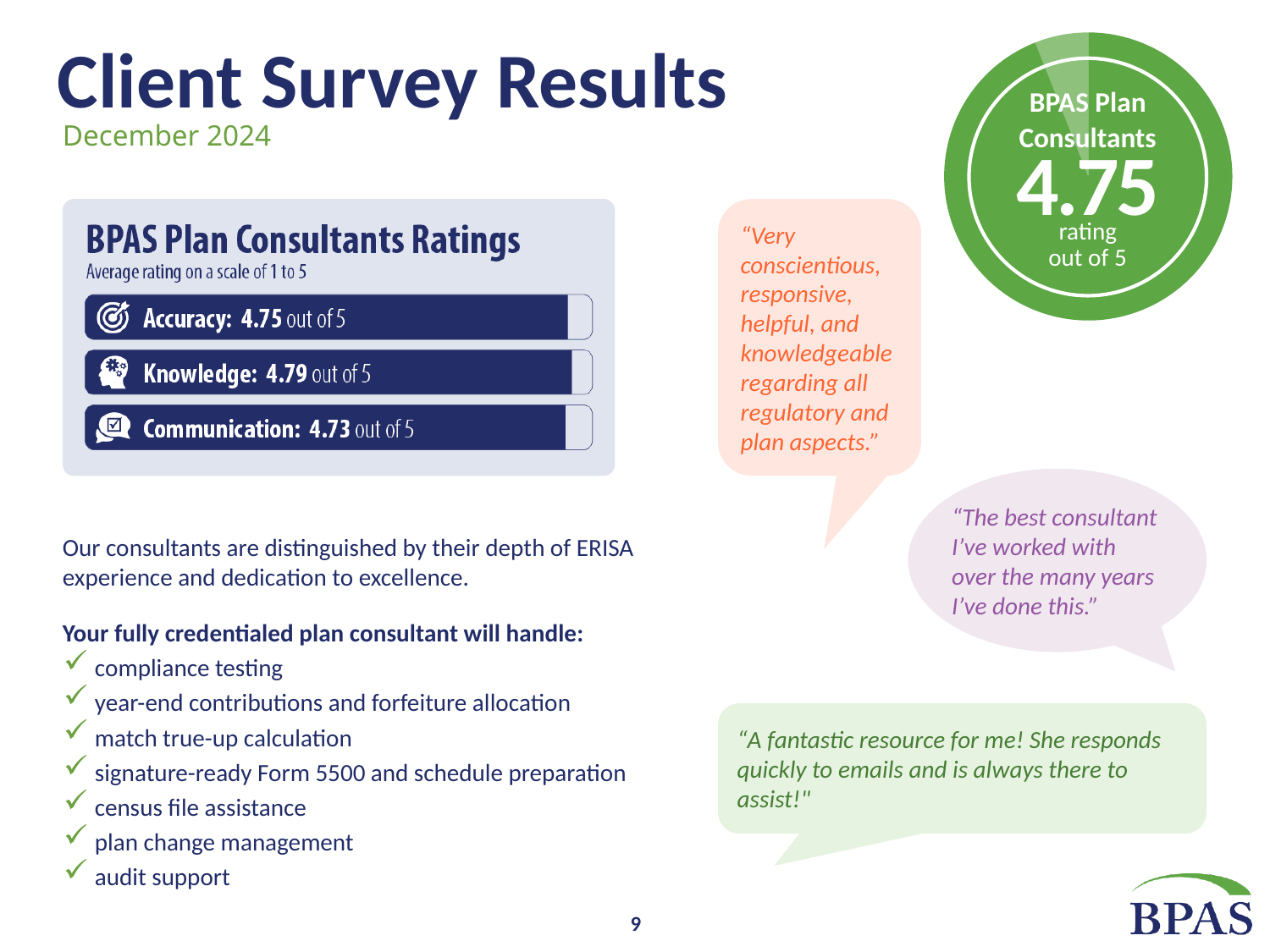
In the BPAS Plan Consultants Ratings chart, which category has the highest rating? Knowledge In the BPAS Plan Consultants Ratings chart, what is the rating for Accuracy? 4.75 out of 5 In the BPAS Plan Consultants Ratings chart, which category has the lowest rating? Communication In the BPAS Plan Consultants Ratings chart, what is the rating for Communication? 4.73 out of 5 In the BPAS Plan Consultants Ratings chart, what is the difference between the Knowledge rating and the Accuracy rating? 0.04 In the BPAS Plan Consultants Ratings chart, which is rated higher, Accuracy or Communication? Accuracy How many categories are rated in the BPAS Plan Consultants Ratings chart? 3 What kind of chart is the BPAS Plan Consultants Ratings chart? Bar chart According to the subtitle of the BPAS Plan Consultants Ratings chart, on what scale are the ratings given? A scale of 1 to 5 In the BPAS Plan Consultants Ratings chart, what is the difference between the Knowledge rating and the Communication rating? 0.06 What overall rating out of 5 is shown in the green circle for BPAS Plan Consultants? 4.75 In the BPAS Plan Consultants Ratings chart, what is the rating for Knowledge? 4.79 out of 5